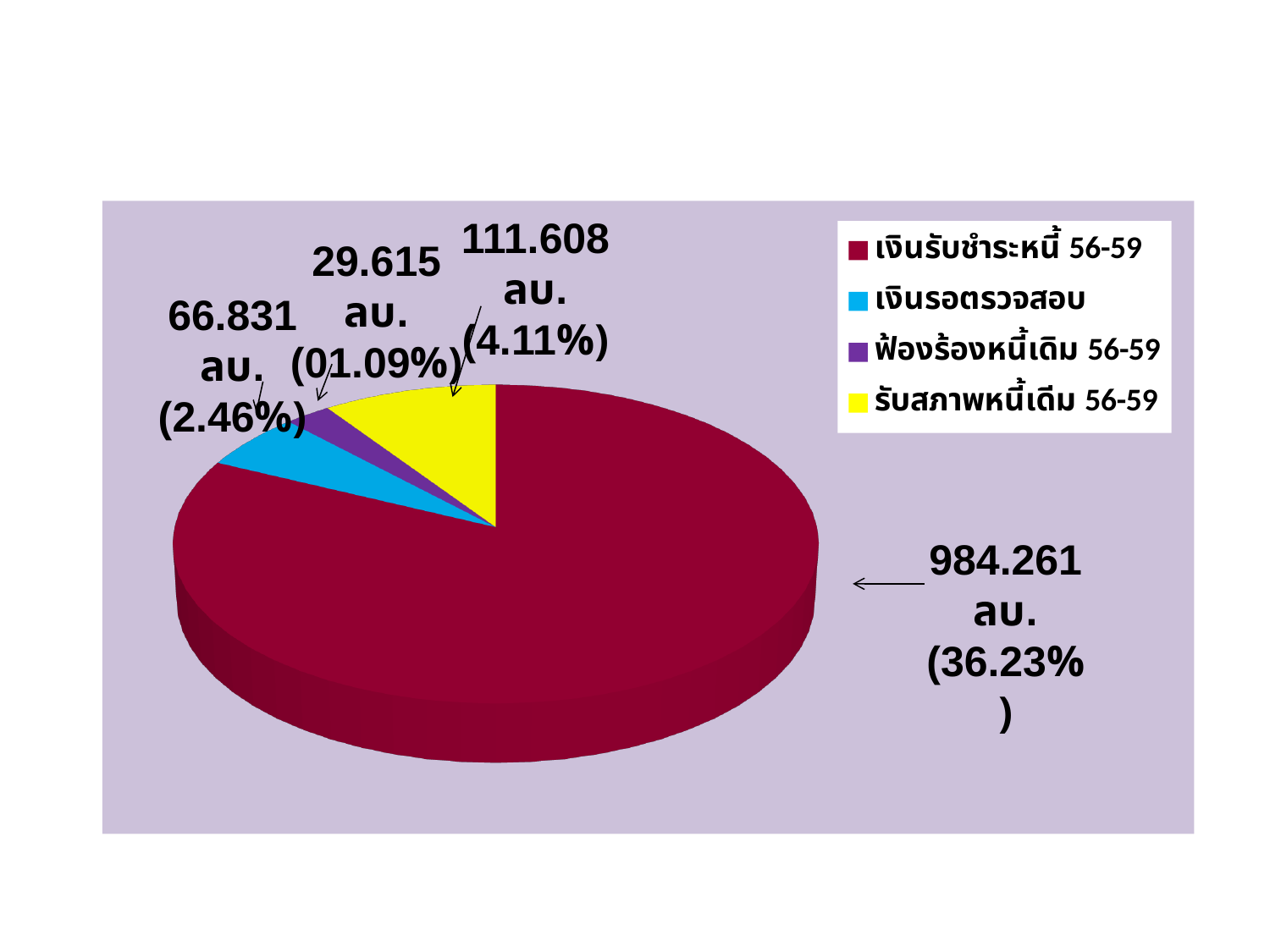
What percentage share is printed for รับสภาพหนี้เดิม 56-59? 4.11% Which category has the largest slice of the pie? เงินรับชำระหนี้ 56-59 What kind of chart is shown on the slide? Pie chart What value is shown for ฟ้องร้องหนี้เดิม 56-59? 29.615 ลบ. What value is shown for เงินรับชำระหนี้ 56-59? 984.261 ลบ. Which colour represents เงินรอตรวจสอบ in the pie chart? Blue Which category has the smallest slice of the pie? ฟ้องร้องหนี้เดิม 56-59 What is the difference between the values for รับสภาพหนี้เดิม 56-59 and เงินรอตรวจสอบ? 44.777 ลบ. What value is shown for เงินรอตรวจสอบ? 66.831 ลบ. What value is shown for รับสภาพหนี้เดิม 56-59? 111.608 ลบ. How many entries does the legend list? 4 How many slices does the pie chart have? 4